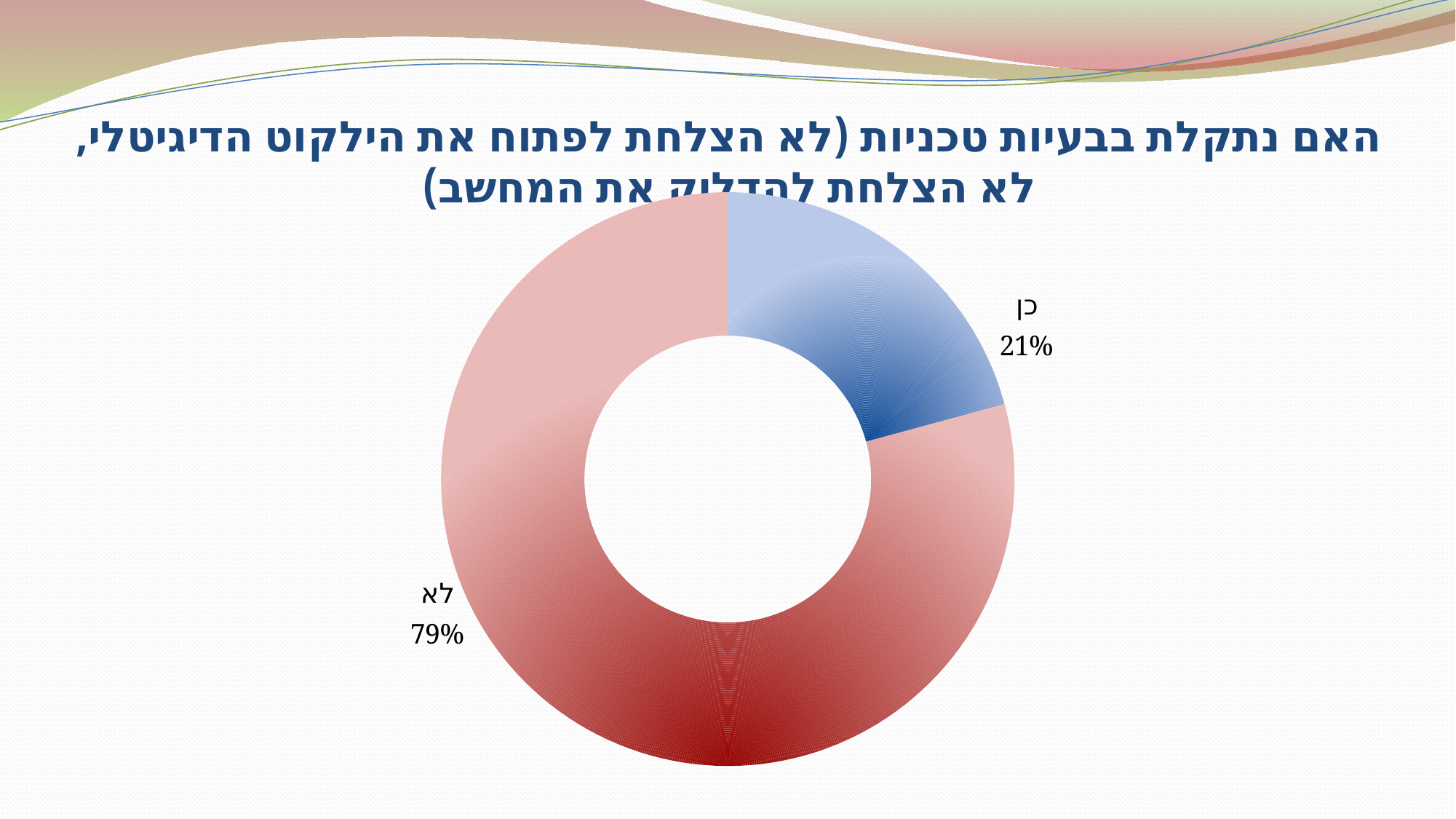
Which slice is larger, "כן" or "לא"? לא What percentage is shown for the "כן" (yes) slice? 21% Which category has the largest share of the chart? לא What colour is the "כן" slice? Blue What colour is the "לא" slice? Red What is the difference in percentage points between the "לא" and "כן" slices? 58 How many categories are shown in the chart? 2 What percentage is shown for the "לא" (no) slice? 79% Which category has the smallest share of the chart? כן What kind of chart is shown on the slide? Doughnut (pie) chart What share of the chart does the "כן" slice represent? 21%